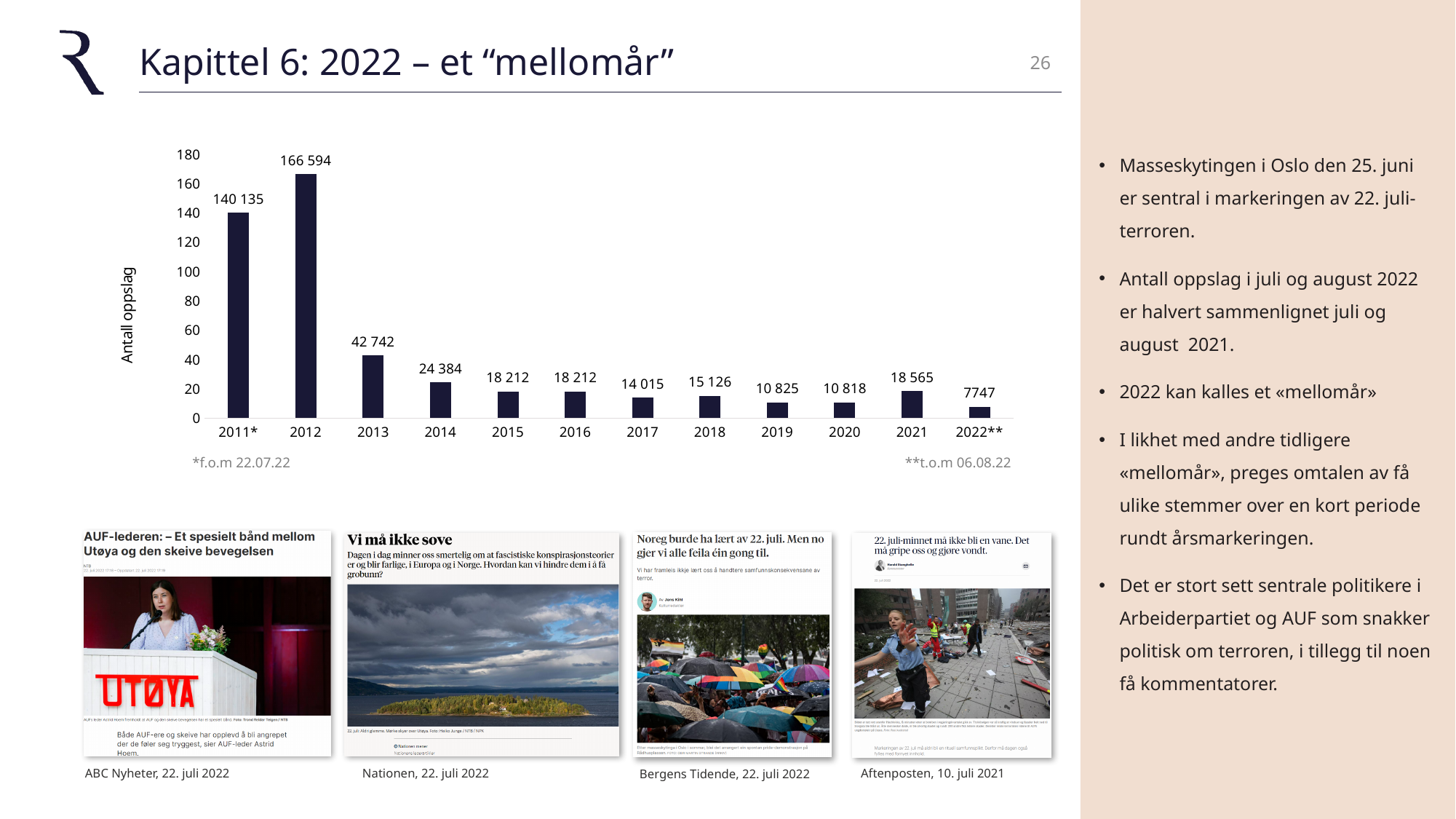
What is the label of the y axis of the chart? Antall oppslag What is the value for 2013 in the chart? 42 742 What is the value for 2022** in the chart? 7747 What is the difference between the values for 2021 and 2022**? 10 818 What type of chart is shown on the slide? bar chart Which year has the lowest value in the chart? 2022** How many years (categories) are shown on the x axis of the chart? 12 What is the difference between the values for 2012 and 2011*? 26 459 Is the value for 2014 greater or less than 20? greater What is the value for 2012 in the chart? 166 594 Which year has the highest value in the chart? 2012 Which is larger, the value for 2018 or the value for 2019? 2018